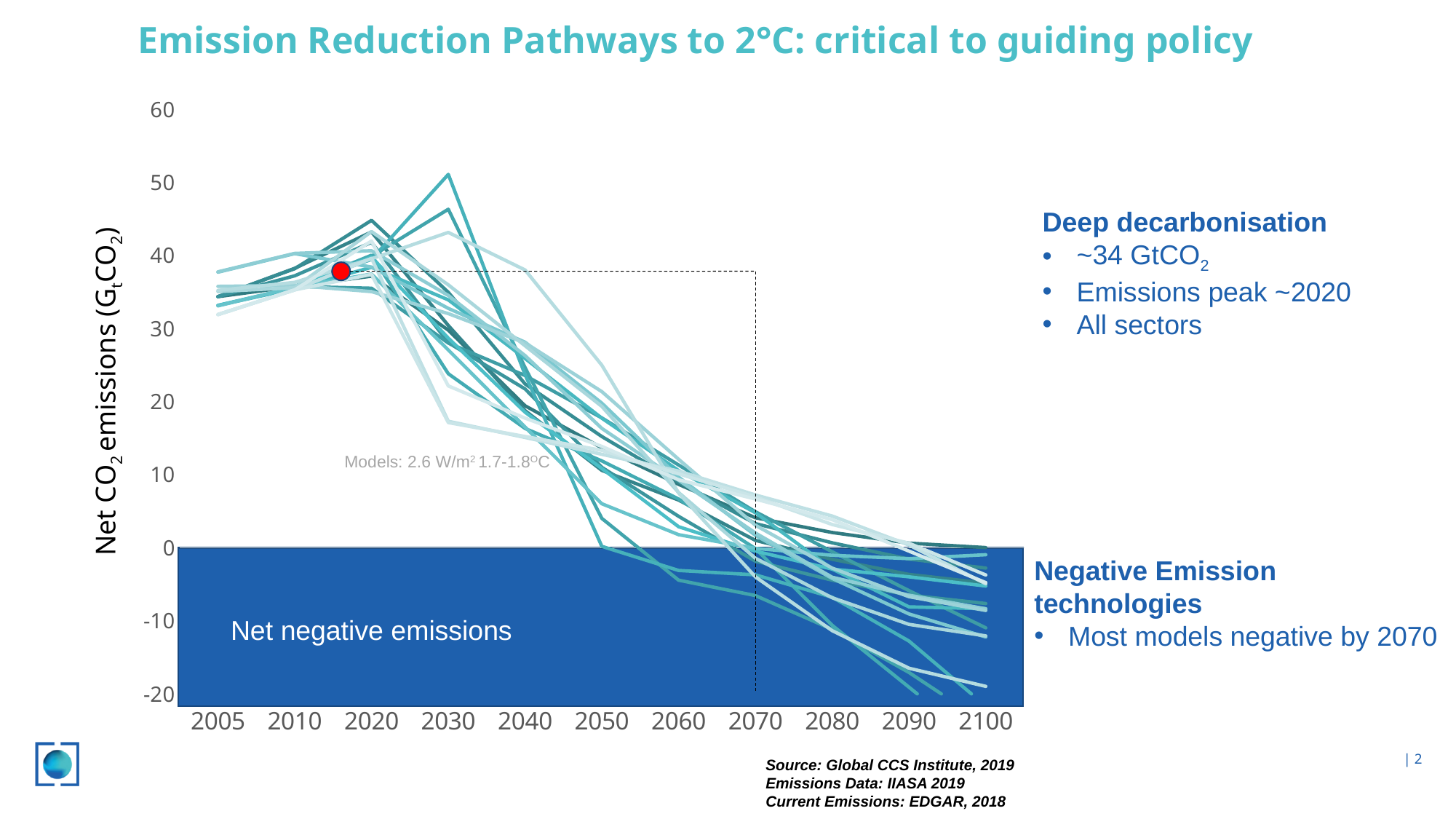
What is the title of the slide containing the chart? Emission Reduction Pathways to 2°C: critical to guiding policy What is the first year shown on the horizontal axis? 2005 How many year labels are shown along the horizontal axis? 11 Overall, do the emission pathways rise or fall between 2030 and 2100? fall What is the last year shown on the horizontal axis? 2100 Is the peak value of the highest pathway around 2030 greater or less than 40? greater In 2005, are the pathway values greater or less than 40? less What is the highest tick value shown on the vertical axis? 60 What kind of chart is shown on the slide? line chart In 2005, are the pathway values greater or less than 30? greater What is the label on the vertical axis of the chart? Net CO2 emissions (GtCO2) What is the lowest tick value shown on the vertical axis? -20